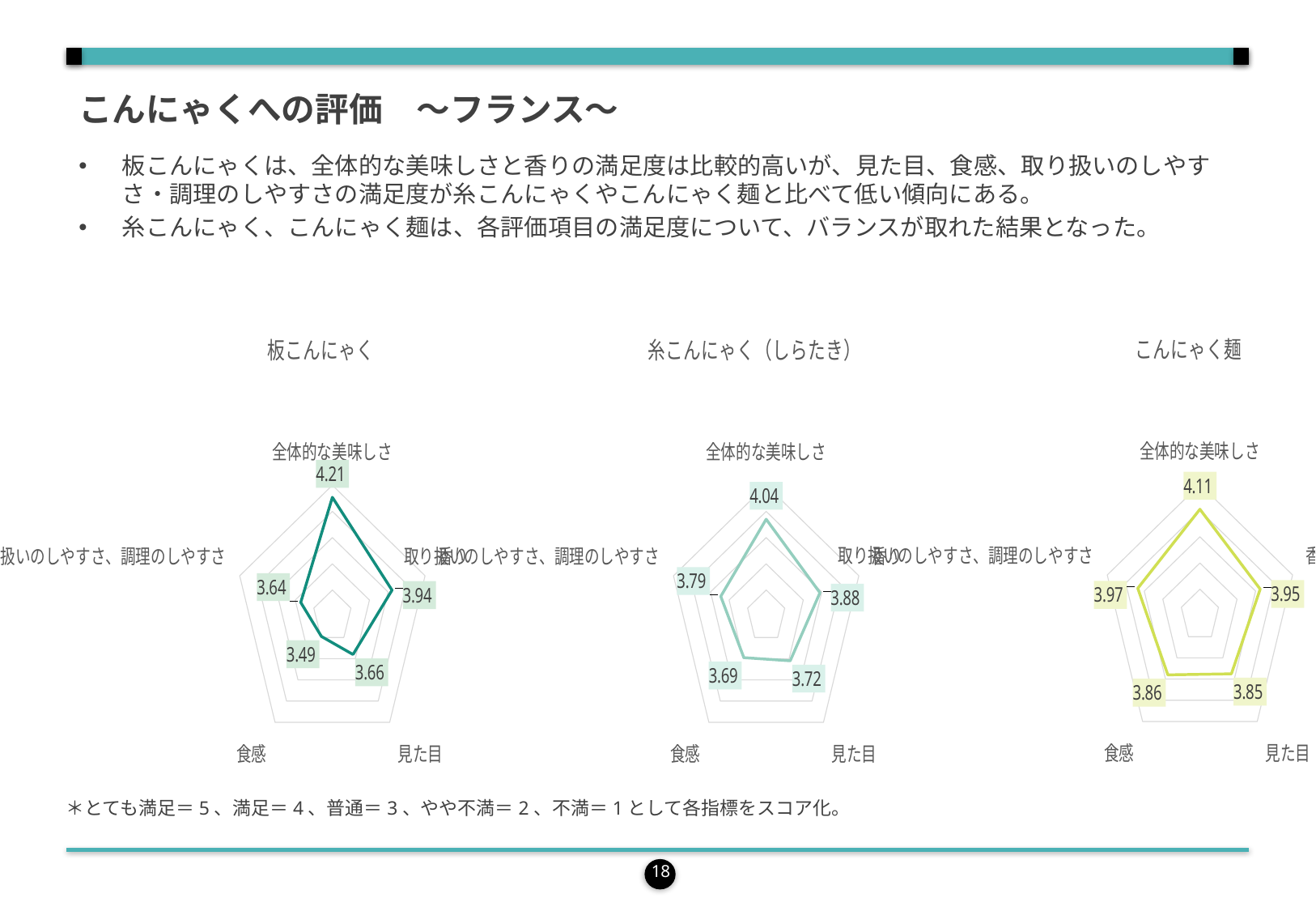
In the 糸こんにゃく（しらたき） chart, what is the score for 食感? 3.69 In the 糸こんにゃく（しらたき） chart, what is the score for 全体的な美味しさ? 4.04 In the 板こんにゃく chart, which item has the highest score? 全体的な美味しさ In the 板こんにゃく chart, what is the score for 全体的な美味しさ? 4.21 How many radar charts are shown on the slide? 3 In the 板こんにゃく chart, how many evaluation axes are plotted? 5 How much higher is the 全体的な美味しさ score for 板こんにゃく than for こんにゃく麺? 0.10 What kind of chart is used for 板こんにゃく on this slide? Radar chart In the 板こんにゃく chart, which item has the lowest score? 食感 In the こんにゃく麺 chart, what is the score for 見た目? 3.85 In the 板こんにゃく chart, what is the difference between the 全体的な美味しさ score and the 食感 score? 0.72 Which has the higher 見た目 score, 糸こんにゃく（しらたき） or こんにゃく麺? こんにゃく麺